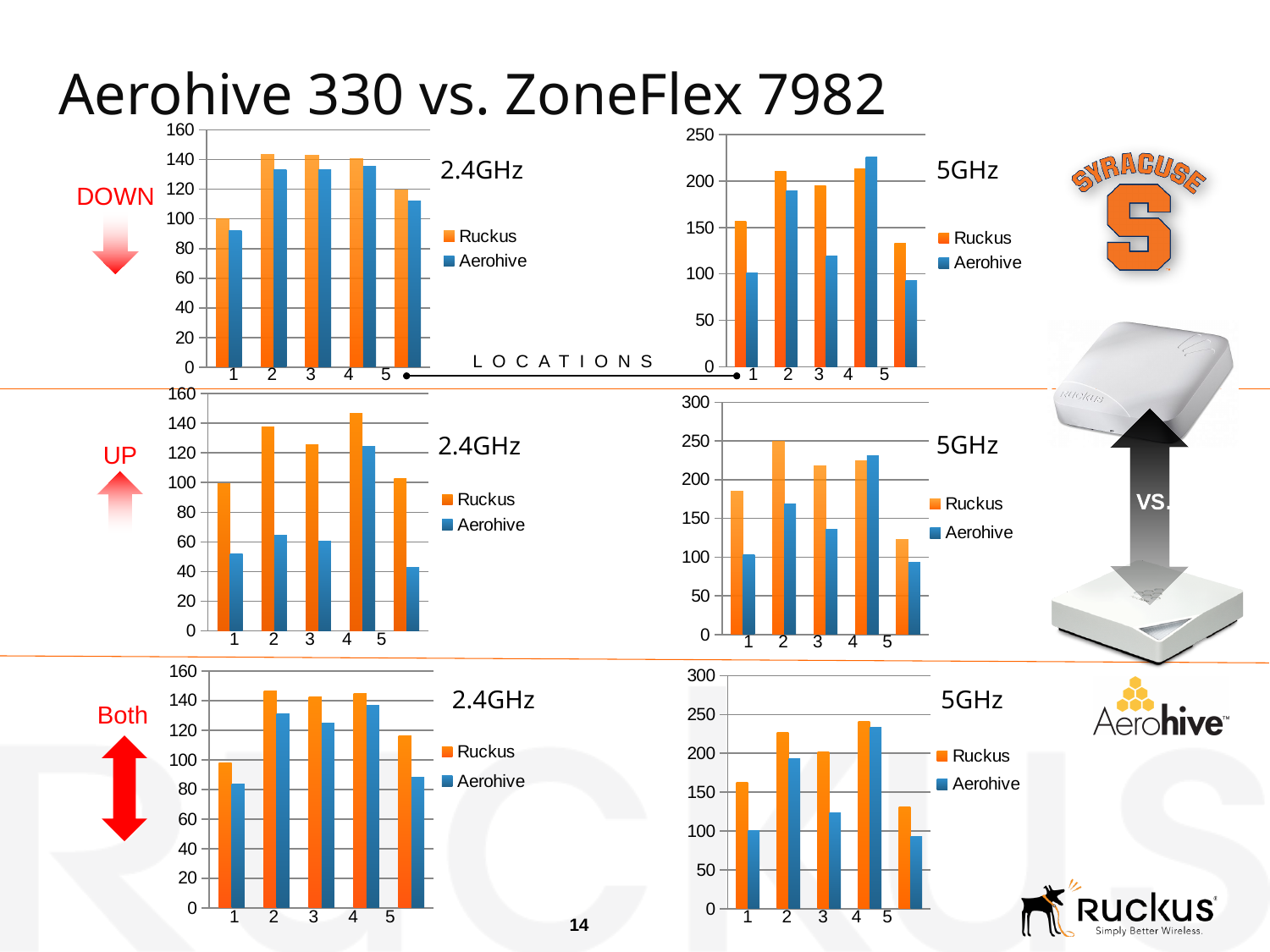
In the UP 2.4GHz chart, is the Aerohive value at location 1 greater or less than 60? less What kind of chart is the DOWN 2.4GHz chart? Bar chart In the Both 5GHz chart, is the Ruckus value at location 5 greater or less than 150? less In the UP 5GHz chart, at which location is the Ruckus value highest? 2 In the DOWN 5GHz chart, is the Ruckus value at location 2 greater or less than 200? greater What are the two legend entries shown on the DOWN 2.4GHz chart? Ruckus and Aerohive In the UP 2.4GHz chart, at which location is the Ruckus value highest? 4 In the Both 2.4GHz chart, which series is larger at location 3, Ruckus or Aerohive? Ruckus How many locations are plotted on the x axis of the Both 2.4GHz chart? 5 In the DOWN 5GHz chart, at which location is the Aerohive bar taller than the Ruckus bar? 4 In the UP 2.4GHz chart, at which location is the Aerohive value lowest? 5 How many series does the legend of the UP 5GHz chart list? 2